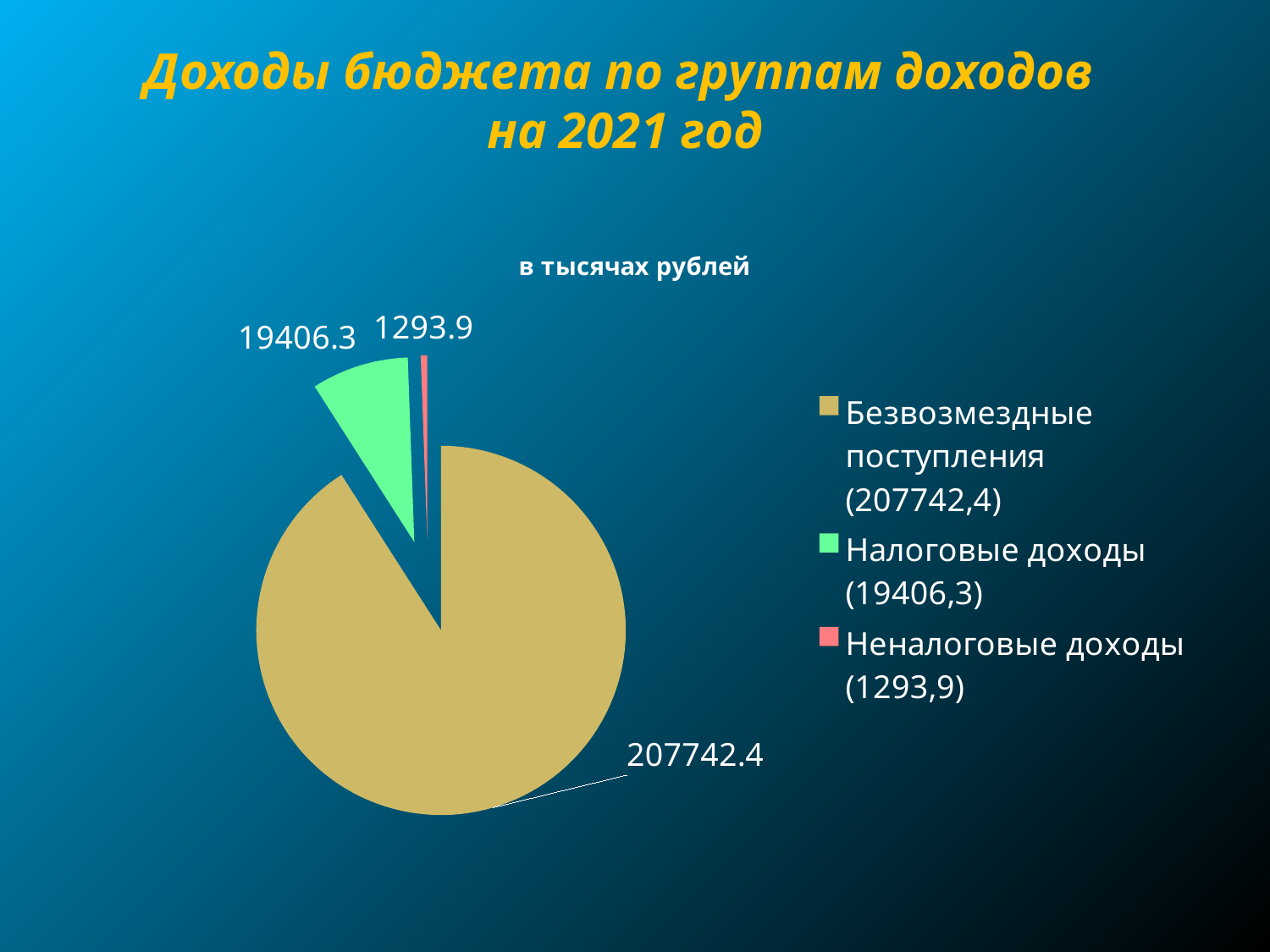
How many slices does the pie chart have? 3 What is the value for Неналоговые доходы? 1293.9 What is the difference between Безвозмездные поступления and Налоговые доходы? 188336.1 What unit is stated in the chart title above the pie? в тысячах рублей Which category has the largest slice of the pie? Безвозмездные поступления What share of the pie does Безвозмездные поступления represent, to one decimal place? 90.9% What is the value for Безвозмездные поступления? 207742.4 What is the difference between Налоговые доходы and Неналоговые доходы? 18112.4 What is the value for Налоговые доходы? 19406.3 What kind of chart is shown on the slide? pie chart Which category has the smallest slice of the pie? Неналоговые доходы Which is larger, Налоговые доходы or Неналоговые доходы? Налоговые доходы